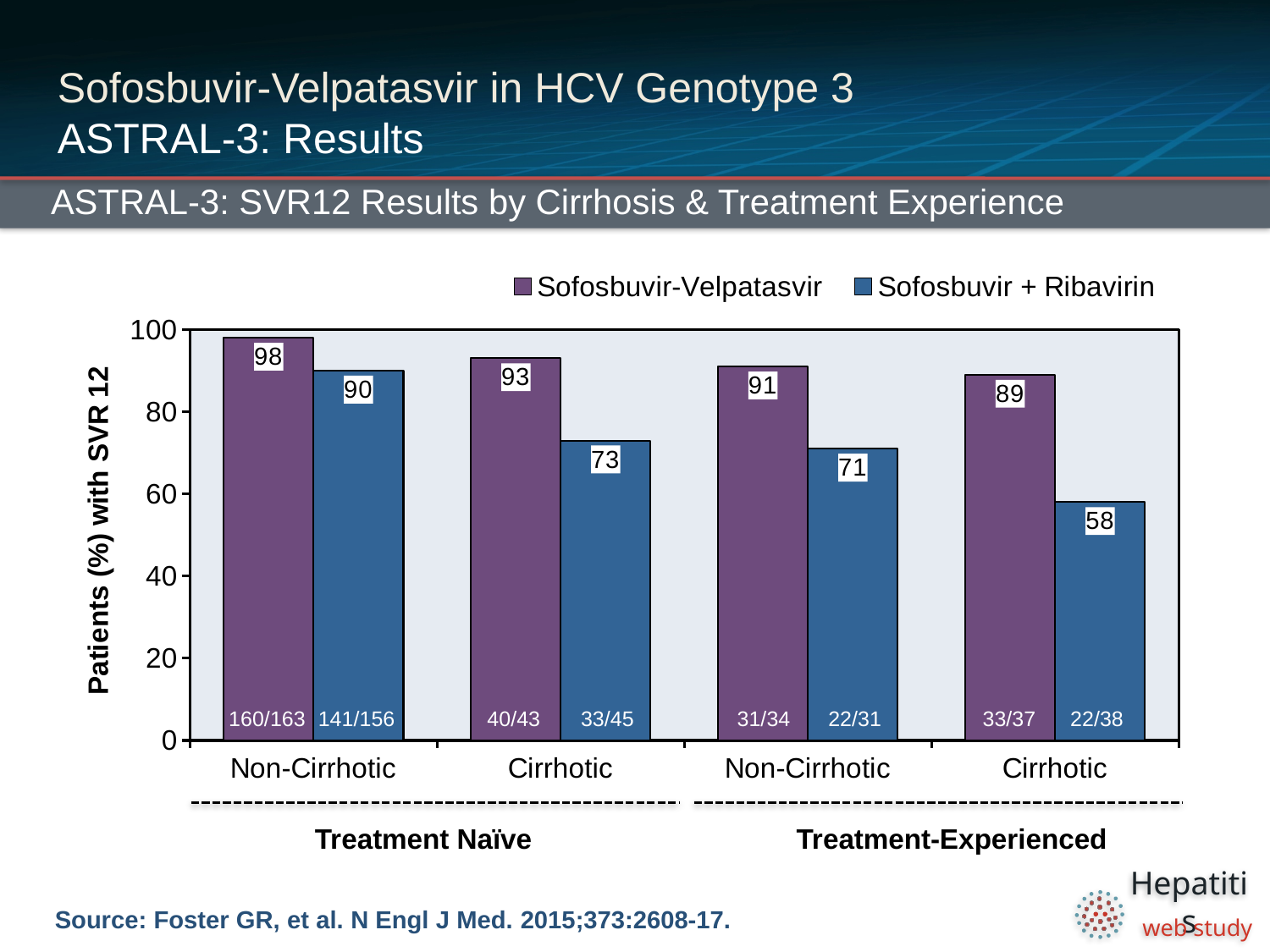
What is the SVR12 rate for Sofosbuvir + Ribavirin in treatment-experienced cirrhotic patients? 58 How many patients achieved SVR12 out of the total in the Sofosbuvir-Velpatasvir treatment-naïve non-cirrhotic group? 160/163 What is the difference in SVR12 rate between Sofosbuvir-Velpatasvir and Sofosbuvir + Ribavirin in treatment-experienced cirrhotic patients? 31 Which group has the lowest SVR12 rate on the chart? Sofosbuvir + Ribavirin, treatment-experienced cirrhotic What is the SVR12 rate for Sofosbuvir + Ribavirin in treatment-naïve cirrhotic patients? 73 How many series does the legend list? 2 Which group has the highest SVR12 rate on the chart? Sofosbuvir-Velpatasvir, treatment-naïve non-cirrhotic Is the SVR12 rate for Sofosbuvir + Ribavirin in treatment-experienced non-cirrhotic patients greater or less than 80? less In treatment-naïve cirrhotic patients, which regimen has the higher SVR12 rate? Sofosbuvir-Velpatasvir What is the label of the y axis? Patients (%) with SVR 12 What is the SVR12 rate for Sofosbuvir-Velpatasvir in treatment-naïve non-cirrhotic patients? 98 What kind of chart is shown on the slide? Bar chart